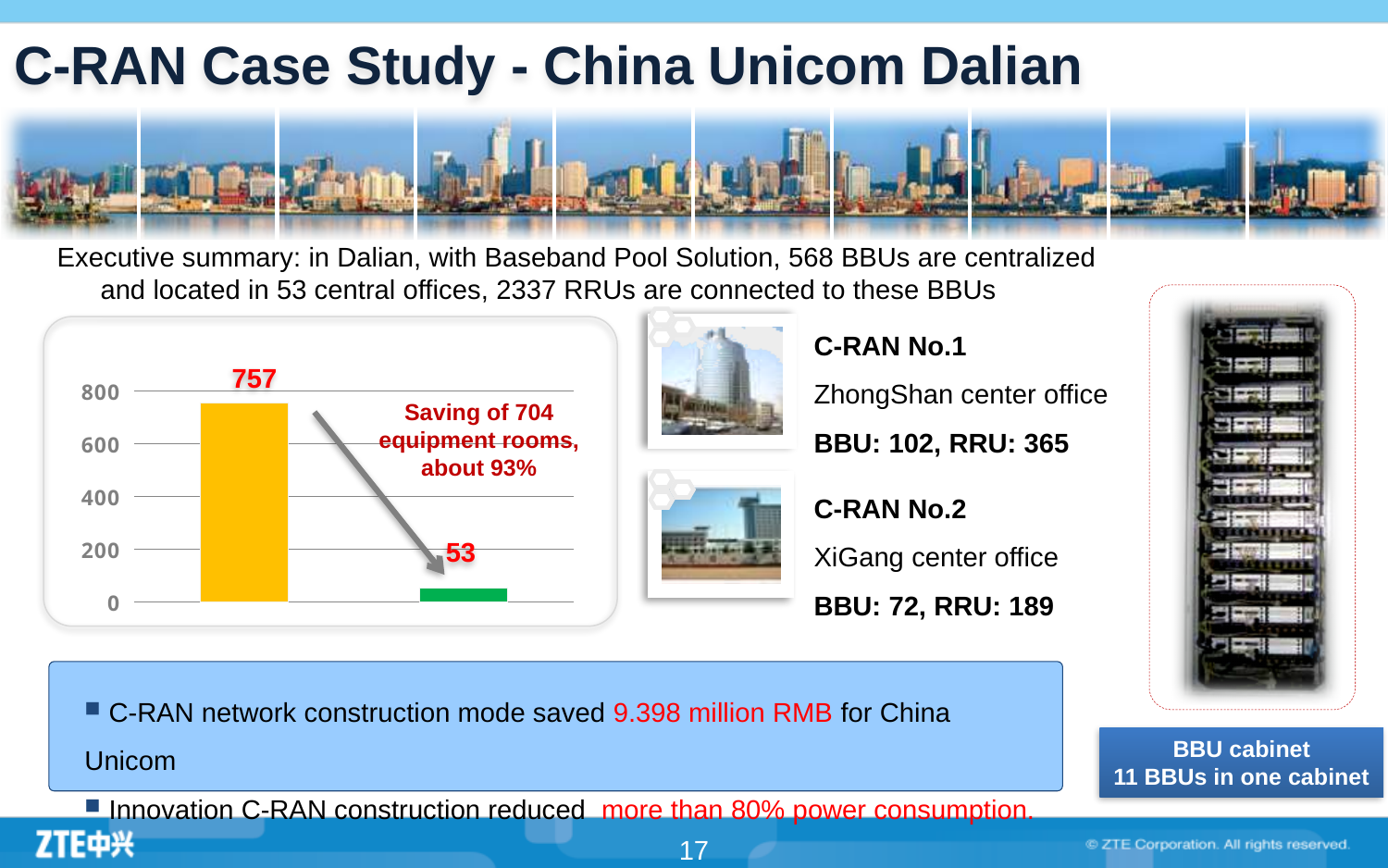
What is the difference between the values of the yellow bar and the green bar? 704 What type of chart is shown on the left of the slide? bar chart What is the value shown on the yellow (left) bar in the chart? 757 According to the annotation on the chart, what percentage saving in equipment rooms is shown? about 93% What is the highest value labelled on the chart's vertical axis? 800 Is the value of the yellow bar greater or less than 600? greater How many bars are plotted in the chart? 2 Which bar has the higher value, the yellow bar or the green bar? the yellow bar What is the value shown on the green (right) bar in the chart? 53 Is the value of the green bar greater or less than 200? less Do the bar values rise or fall from left to right in the chart? fall